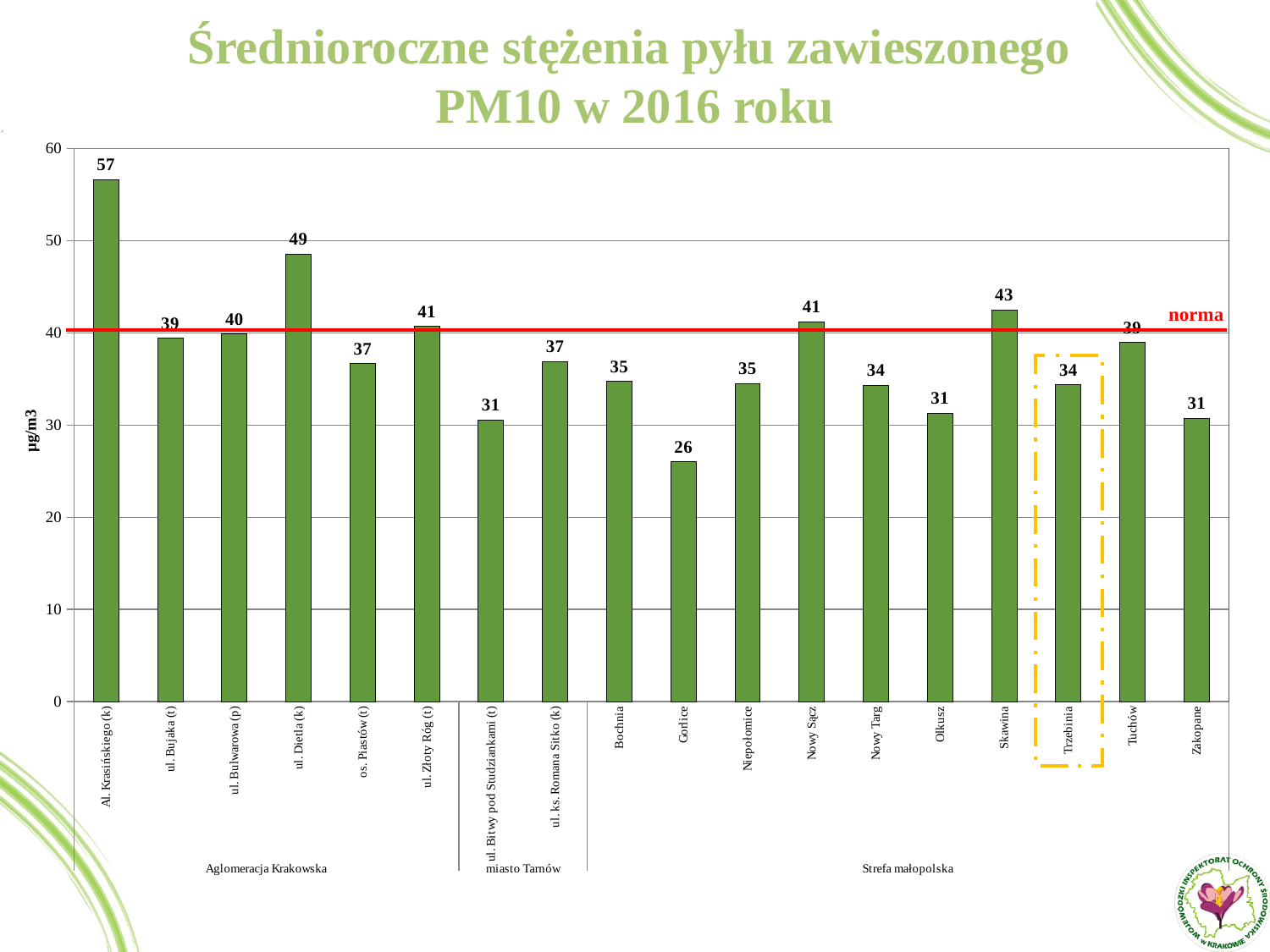
What value is shown for ul. Dietla (k)? 49 What kind of chart is shown on the slide? Bar chart What is the PM10 concentration shown for Al. Krasińskiego (k)? 57 What value is shown for Gorlice? 26 What value is shown for Skawina? 43 How many stations (bars) are shown in the chart? 18 What is the difference between the values for Al. Krasińskiego (k) and Gorlice? 31 Which station has the lowest PM10 concentration? Gorlice What is the label of the red horizontal line drawn across the chart? norma Which station has the highest PM10 concentration? Al. Krasińskiego (k) Which is larger, the value for ul. Dietla (k) or the value for ul. Złoty Róg (t)? ul. Dietla (k) What is the difference between the values for Skawina and Nowy Sącz? 2